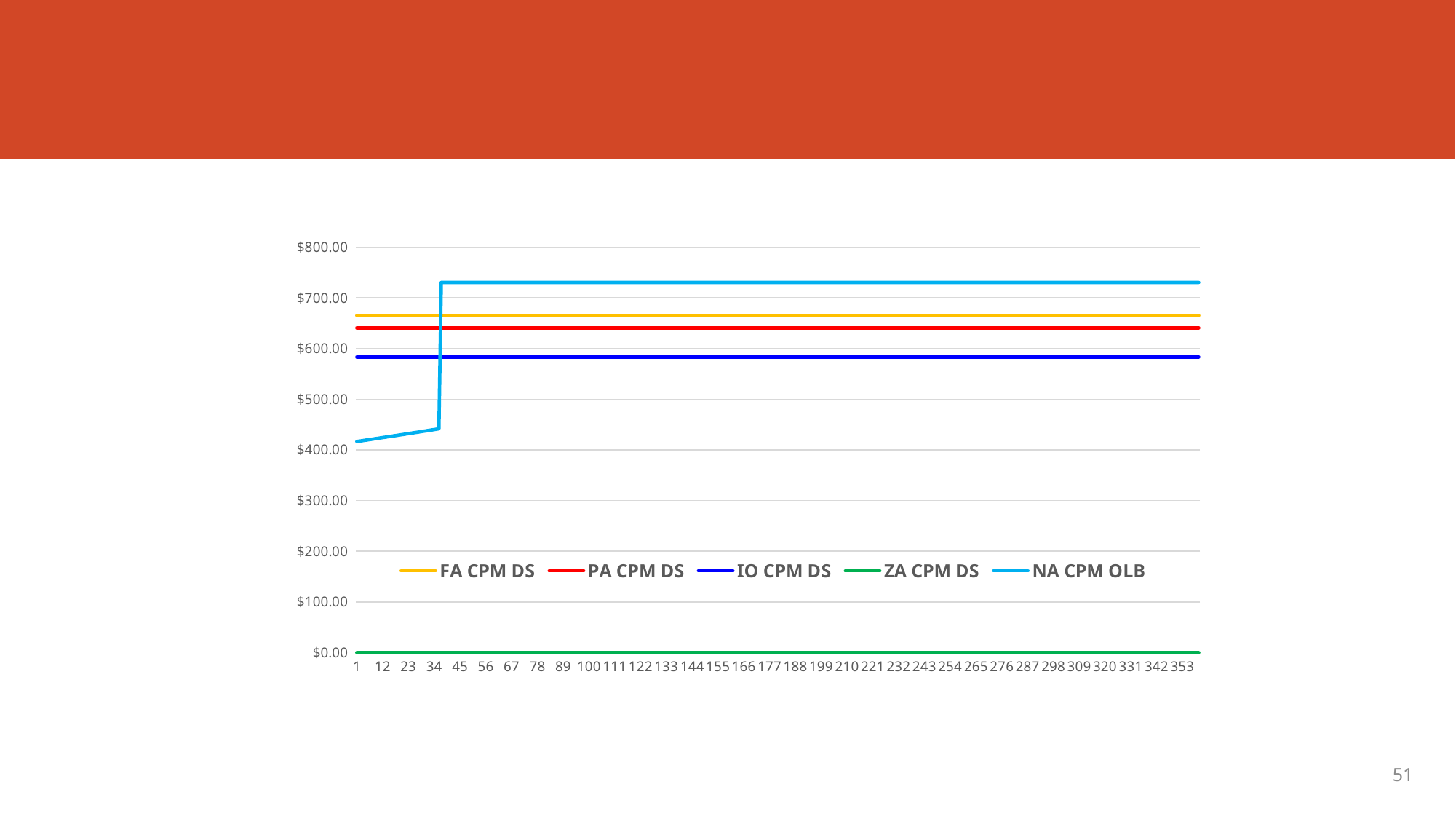
Which series has the lowest values across the chart? ZA CPM DS Which is larger, the value for FA CPM DS or the value for IO CPM DS? FA CPM DS Is the value for NA CPM OLB at point 1 greater or less than $500.00? less Is the value for IO CPM DS greater or less than $500.00? greater What kind of chart is shown on the slide? line chart Does the PA CPM DS line rise, fall, or stay flat along the x axis? stay flat Does the NA CPM OLB line rise or fall along the x axis? rise What colour is the NA CPM OLB line? light blue Is the value for FA CPM DS greater or less than $600.00? greater What value does the ZA CPM DS line sit at? $0.00 How many series does the legend list? 5